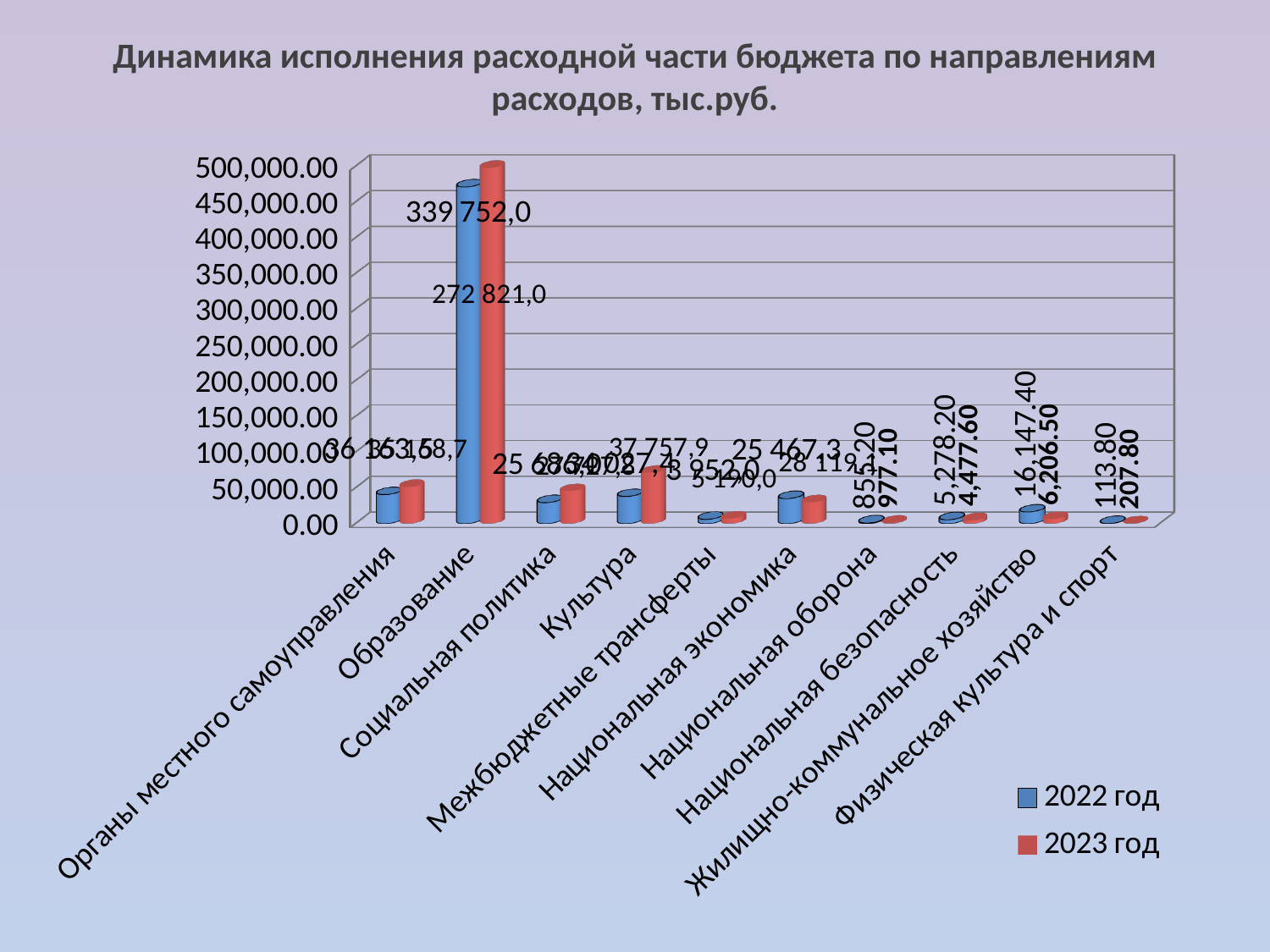
What is the value for Жилищно-коммунальное хозяйство in 2022 год? 16,147.40 What is the value for Физическая культура и спорт in 2023 год? 207.80 How many expenditure categories are shown on the x axis? 10 Is the 2023 год value for Культура greater or less than 100,000.00? less How many series does the legend list? 2 For Национальная безопасность, which year has the larger value, 2022 год or 2023 год? 2022 год What is the value for Национальная оборона in 2023 год? 977.10 What is the difference between the 2023 год and 2022 год values for Физическая культура и спорт? 94.00 What kind of chart is shown on the slide? bar chart Which category has the lowest value for 2022 год? Физическая культура и спорт What is the difference between the 2022 год and 2023 год values for Жилищно-коммунальное хозяйство? 9,940.90 Which category has the highest bars in the chart? Образование